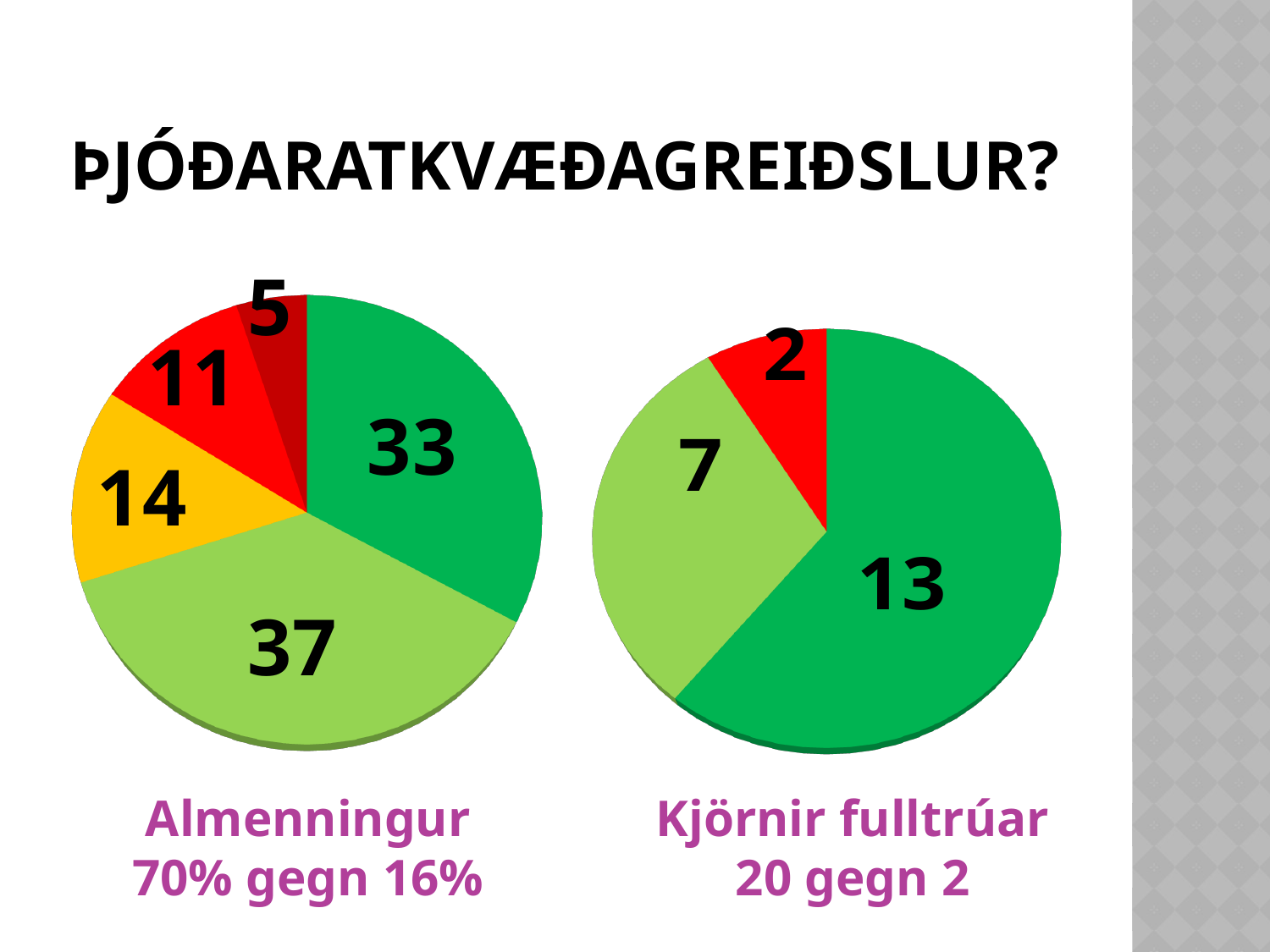
How many slices does the Almenningur pie chart have? 5 In the Kjörnir fulltrúar pie chart, what is the value of the red slice? 2 How many slices does the Kjörnir fulltrúar pie chart have? 3 In the Almenningur pie chart, which slice has the smallest value? 5 In the Almenningur pie chart, what share of the total does the light green slice (37) represent? 37% In the Almenningur pie chart, what is the value of the yellow slice? 14 What kind of charts are shown on the slide? Pie charts In the Almenningur pie chart, what is the difference between the light green slice and the dark green slice? 4 In the Almenningur pie chart, which slice has the largest value? 37 In the Almenningur pie chart, what is the value of the light green slice? 37 In the Kjörnir fulltrúar pie chart, what is the difference between the largest slice and the light green slice? 6 In the Kjörnir fulltrúar pie chart, what is the total of all slices? 22